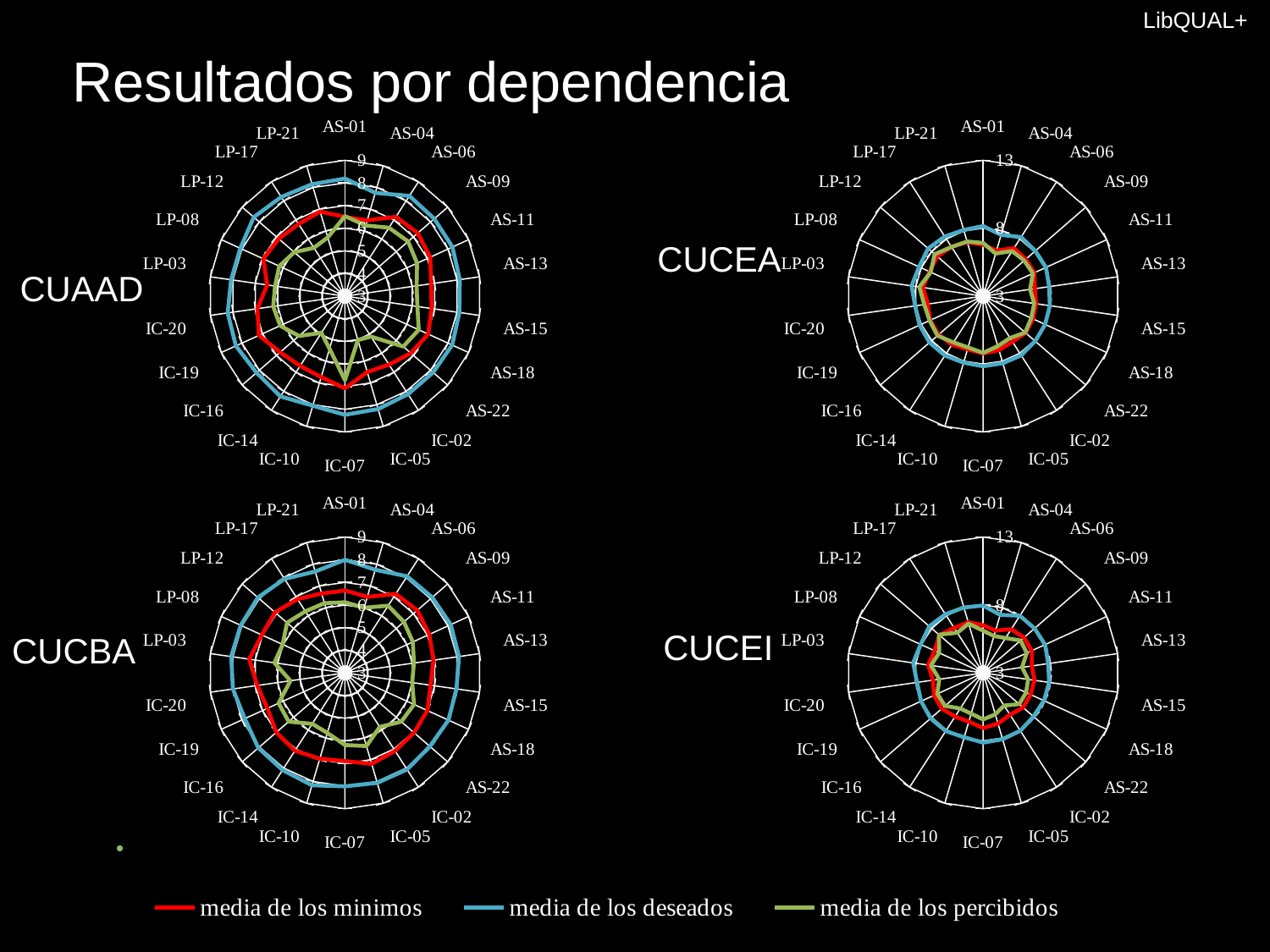
In the CUCEI chart, which is larger for LP-03: media de los deseados or media de los percibidos? media de los deseados In the CUAAD chart, is the media de los percibidos value for LP-03 greater or less than 7? less How many series does the legend list? 3 What kind of chart is the CUAAD chart? radar chart How many categories are plotted around the CUCEI chart? 22 What is the highest value shown on the axis of the CUCEA chart? 13 In the CUAAD chart, which is larger for AS-01: media de los deseados or media de los minimos? media de los deseados In the CUAAD chart, is the media de los deseados value for AS-01 greater or less than 7? greater In the CUCBA chart, which is larger for IC-07: media de los minimos or media de los percibidos? media de los minimos In the CUCBA chart, is the media de los percibidos value for IC-07 greater or less than 7? less How many charts are shown on the slide? 4 What is the title of the slide containing the charts? Resultados por dependencia